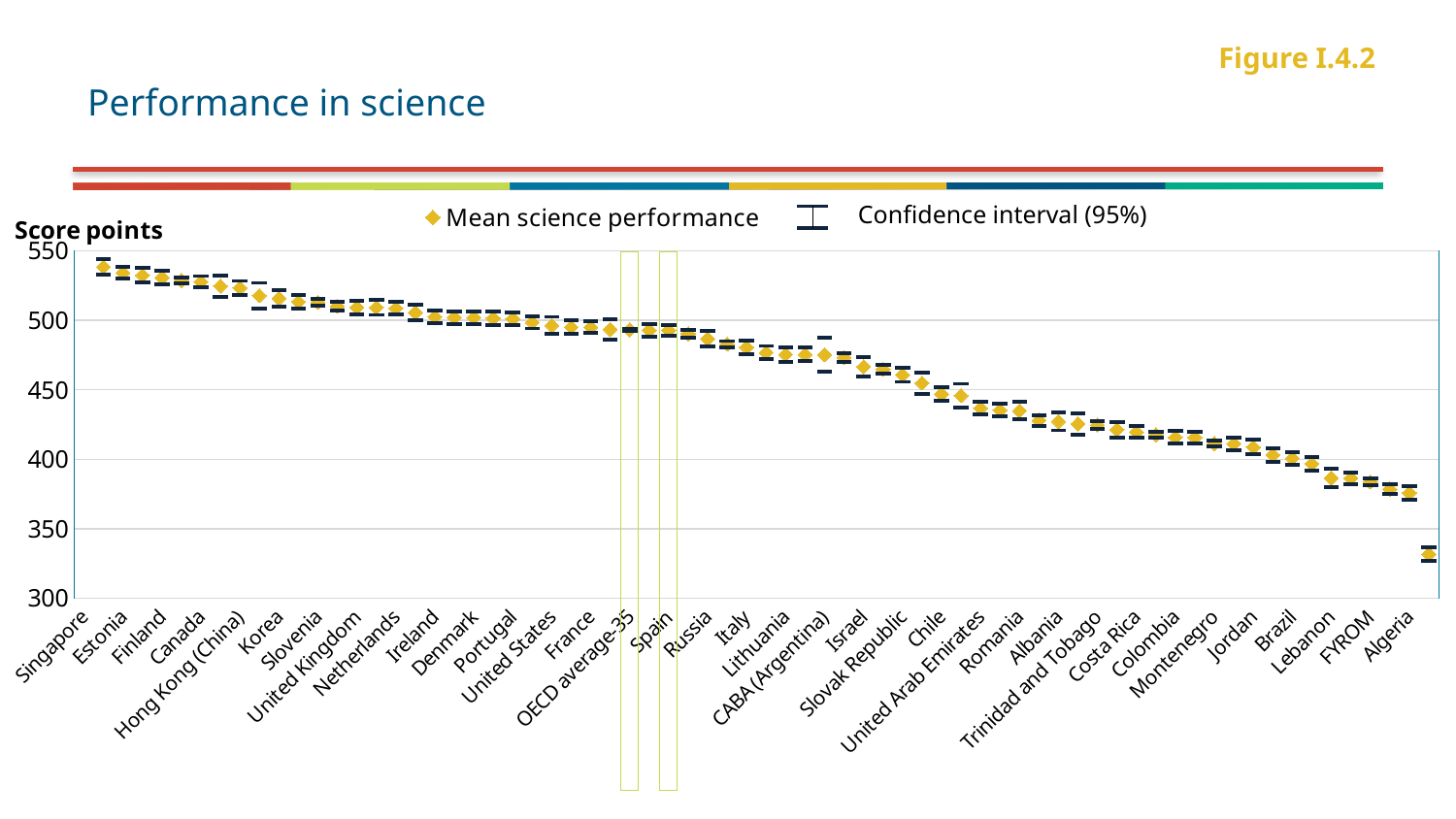
How many series does the legend list? 2 Which labeled country has the highest mean science performance? Singapore Is the mean science performance for Lebanon greater or less than 400? less Is the mean science performance for Singapore greater or less than 500? greater Is the mean science performance for Korea greater or less than 500? greater What is the label on the vertical axis? Score points What is the title of the chart? Performance in science Which has a higher mean science performance, Estonia or Italy? Estonia Do the mean science performance values rise or fall from left to right along the x axis? Fall What kind of chart is this? Scatter chart with confidence interval error bars